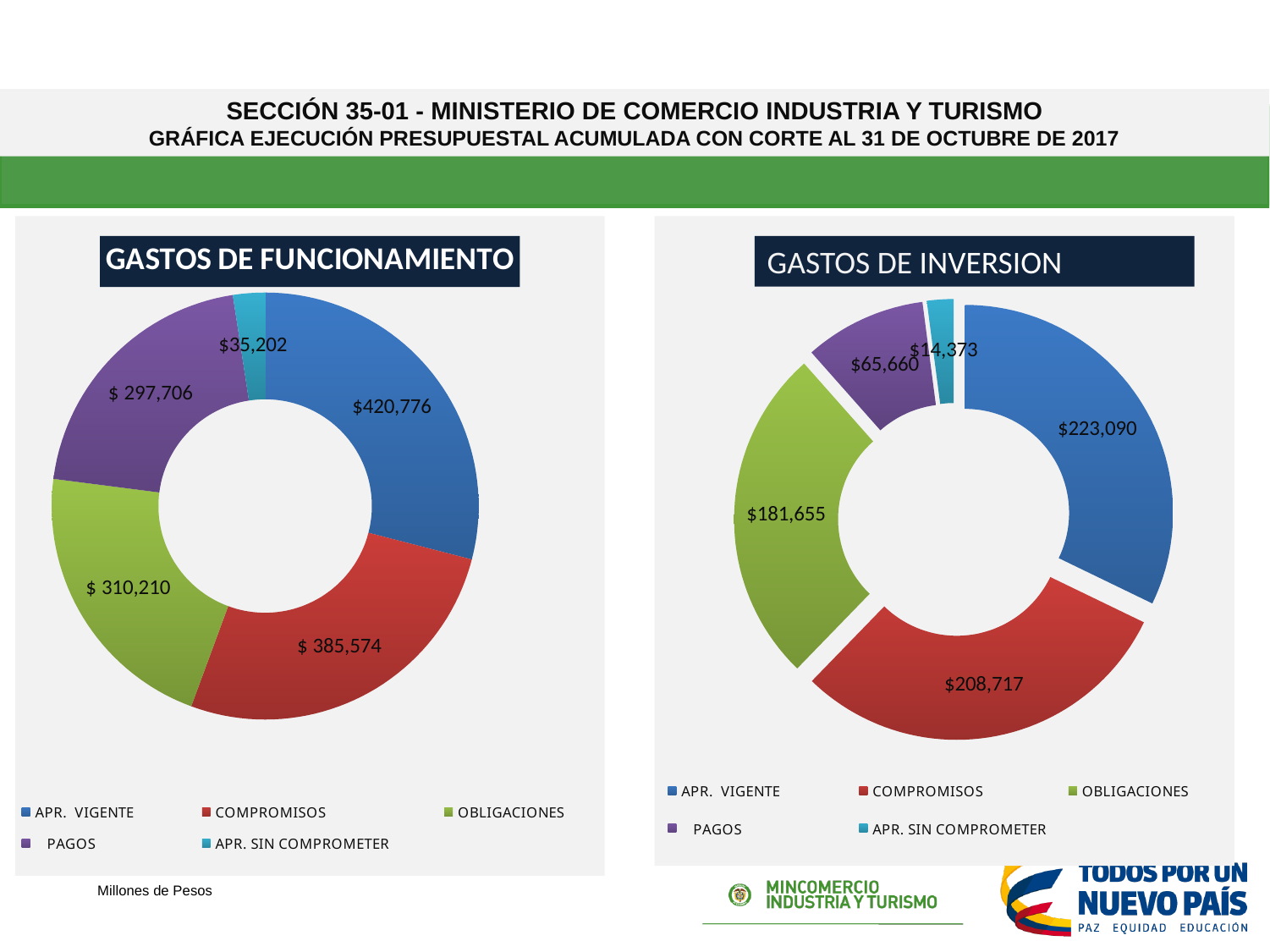
In the GASTOS DE INVERSION chart, which category has the largest value? APR. VIGENTE In the GASTOS DE FUNCIONAMIENTO chart, which is larger, OBLIGACIONES or PAGOS? OBLIGACIONES What kind of chart is the GASTOS DE FUNCIONAMIENTO chart? doughnut chart In the GASTOS DE INVERSION chart, what is the difference between OBLIGACIONES and PAGOS? $115,995 In the GASTOS DE FUNCIONAMIENTO chart, what is the difference between APR. VIGENTE and COMPROMISOS? $35,202 In the GASTOS DE FUNCIONAMIENTO chart, which category has the smallest value? APR. SIN COMPROMETER In the GASTOS DE FUNCIONAMIENTO chart, what is the value for APR. VIGENTE? $420,776 In the GASTOS DE INVERSION chart, what is the value for COMPROMISOS? $208,717 How many categories does the GASTOS DE INVERSION chart show? 5 In the GASTOS DE FUNCIONAMIENTO chart, what is the value for PAGOS? $ 297,706 In the GASTOS DE INVERSION chart, which colour represents OBLIGACIONES? green In the GASTOS DE INVERSION chart, what is the value for APR. SIN COMPROMETER? $14,373